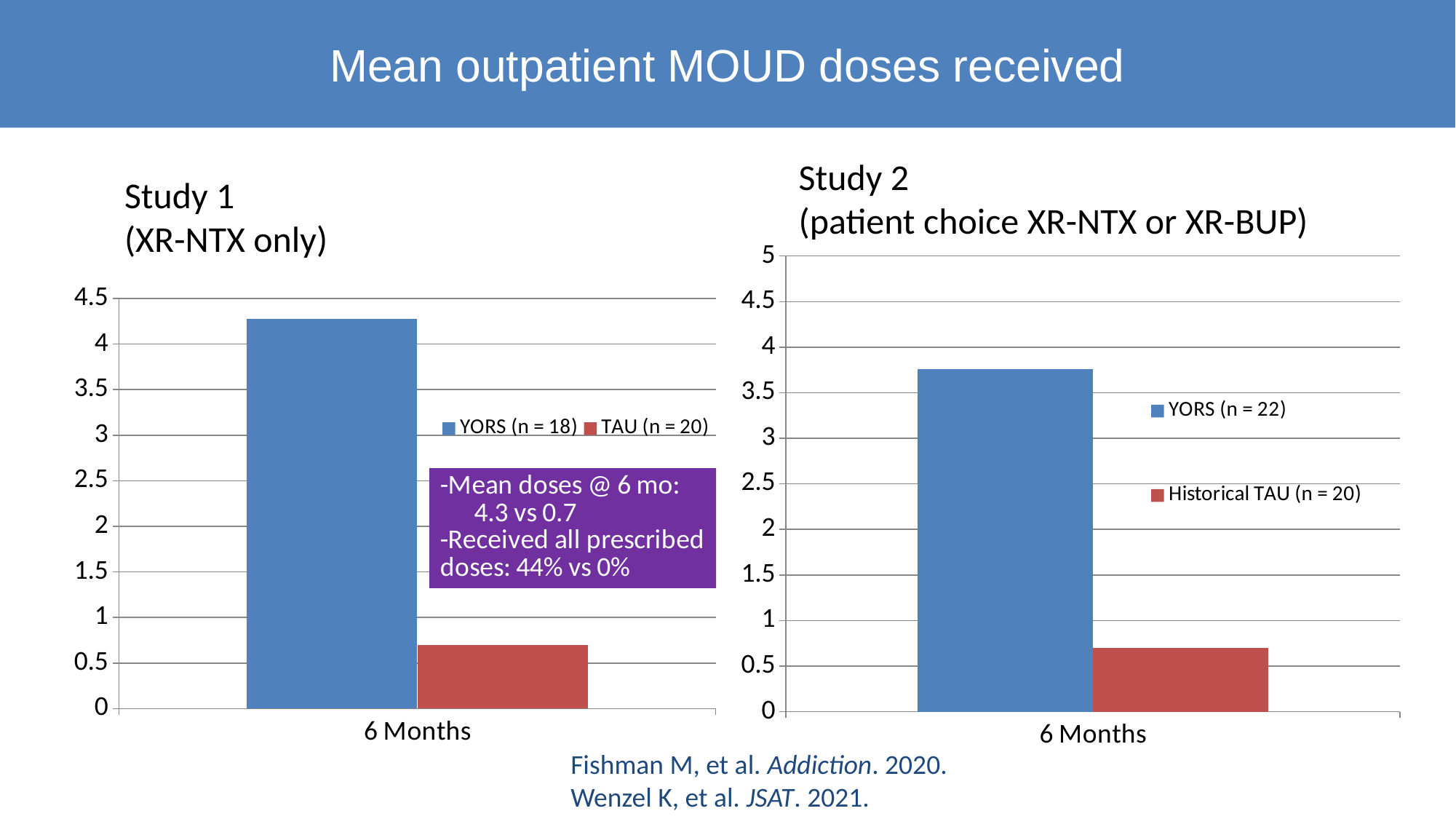
In the Study 2 (patient choice XR-NTX or XR-BUP) chart, is the value for YORS (n = 22) greater or less than 3.5? greater What kind of chart is the Study 1 (XR-NTX only) chart? bar chart In the Study 2 (patient choice XR-NTX or XR-BUP) chart, how many series does the legend list? 2 In the Study 1 (XR-NTX only) chart, is the value for TAU (n = 20) greater or less than 1? less In the Study 2 (patient choice XR-NTX or XR-BUP) chart, which series has the lower value at 6 Months? Historical TAU (n = 20) In the Study 1 (XR-NTX only) chart, what is the mean number of doses at 6 months for YORS, as stated in the text box? 4.3 What kind of chart is the Study 2 (patient choice XR-NTX or XR-BUP) chart? bar chart In the Study 2 (patient choice XR-NTX or XR-BUP) chart, is the value for Historical TAU (n = 20) greater or less than 1? less In the Study 1 (XR-NTX only) chart, which series has the higher value at 6 Months? YORS (n = 18) In the Study 1 (XR-NTX only) chart, how many series does the legend list? 2 In the Study 1 (XR-NTX only) chart, what is the mean number of doses at 6 months for TAU, as stated in the text box? 0.7